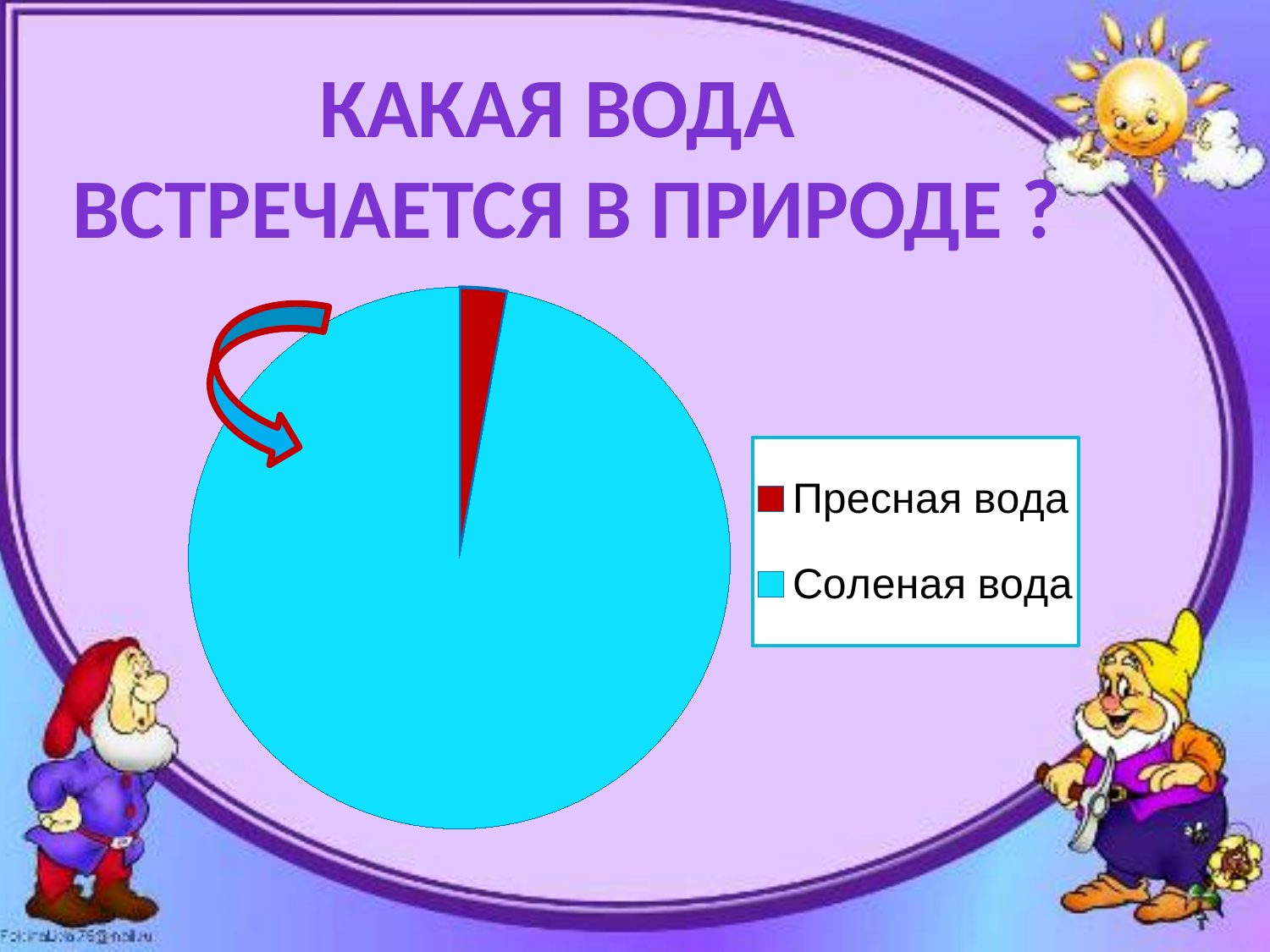
Which category has the smallest slice in the pie chart? Пресная вода What colour is the slice for Соленая вода in the pie chart? light blue Which category has the largest slice in the pie chart? Соленая вода What colour is the slice for Пресная вода in the pie chart? red How many entries does the legend of the pie chart list? 2 What kind of chart is shown on the slide? pie chart How many slices does the pie chart have? 2 Which slice is larger in the pie chart, Пресная вода or Соленая вода? Соленая вода